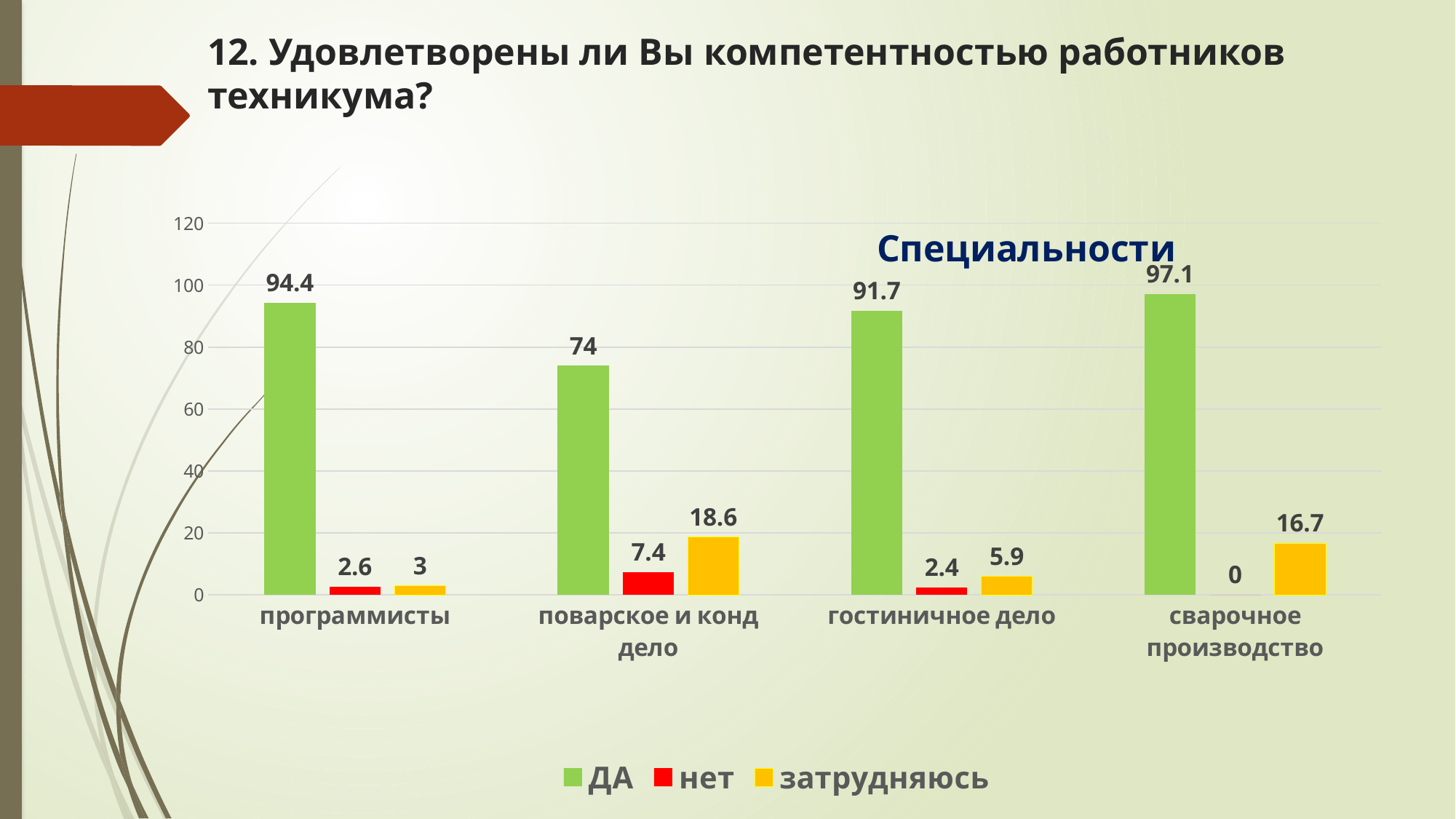
Which colour represents the нет series? red What is the value of ДА for программисты? 94.4 What is the value of нет for гостиничное дело? 2.4 What is the value of затрудняюсь for поварское и конд дело? 18.6 Which is larger: the затрудняюсь value for поварское и конд дело or for сварочное производство? поварское и конд дело What is the difference between the ДА values for сварочное производство and поварское и конд дело? 23.1 How many series does the legend list? 3 How many categories are shown on the x axis? 4 Which category has the highest ДА value? сварочное производство What kind of chart is shown on the slide? bar chart Which category has the lowest ДА value? поварское и конд дело What is the value of нет for сварочное производство? 0